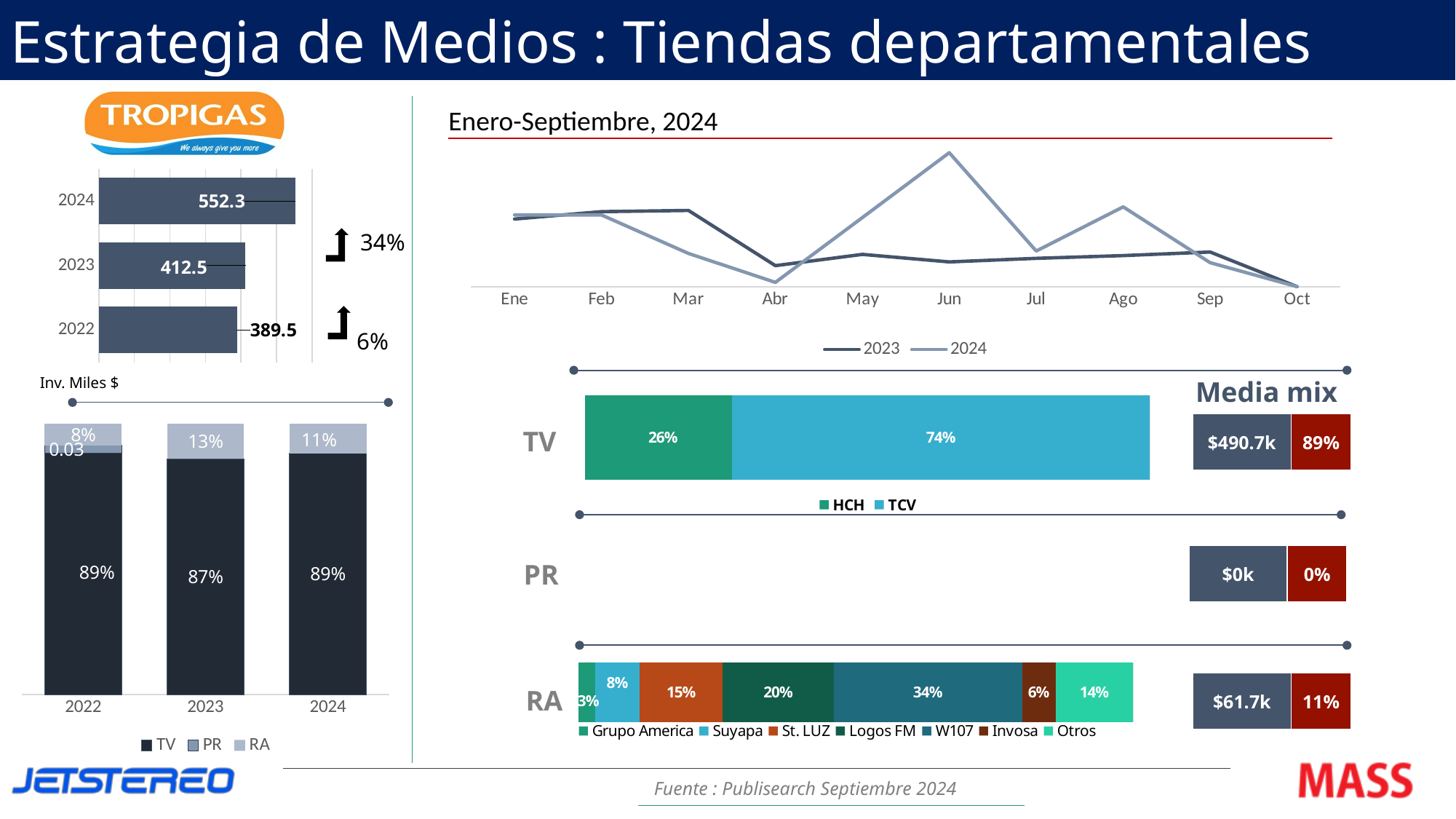
How many series does the legend of the stacked bar chart at the bottom left list? 3 How many months are shown on the x axis of the line chart titled Enero-Septiembre, 2024? 10 In the RA stacked bar on the right, which station has the largest share? W107 In the horizontal bar chart at the top left, what is the value for 2022? 389.5 In the line chart titled Enero-Septiembre, 2024, in which month does the 2024 line reach its highest point? Jun In the horizontal bar chart at the top left, what is the difference between the 2024 and 2023 values? 139.8 In the stacked bar chart at the bottom left, what is the TV share for 2023? 87% In the stacked bar chart at the bottom left, what is the RA share for 2024? 11% In the horizontal bar chart at the top left, what is the value for 2024? 552.3 In the RA stacked bar on the right, what is the difference between the Logos FM and St. LUZ shares? 5% In the TV stacked bar on the right, what is the share for TCV? 74% In the horizontal bar chart at the top left, which year has the lowest value? 2022